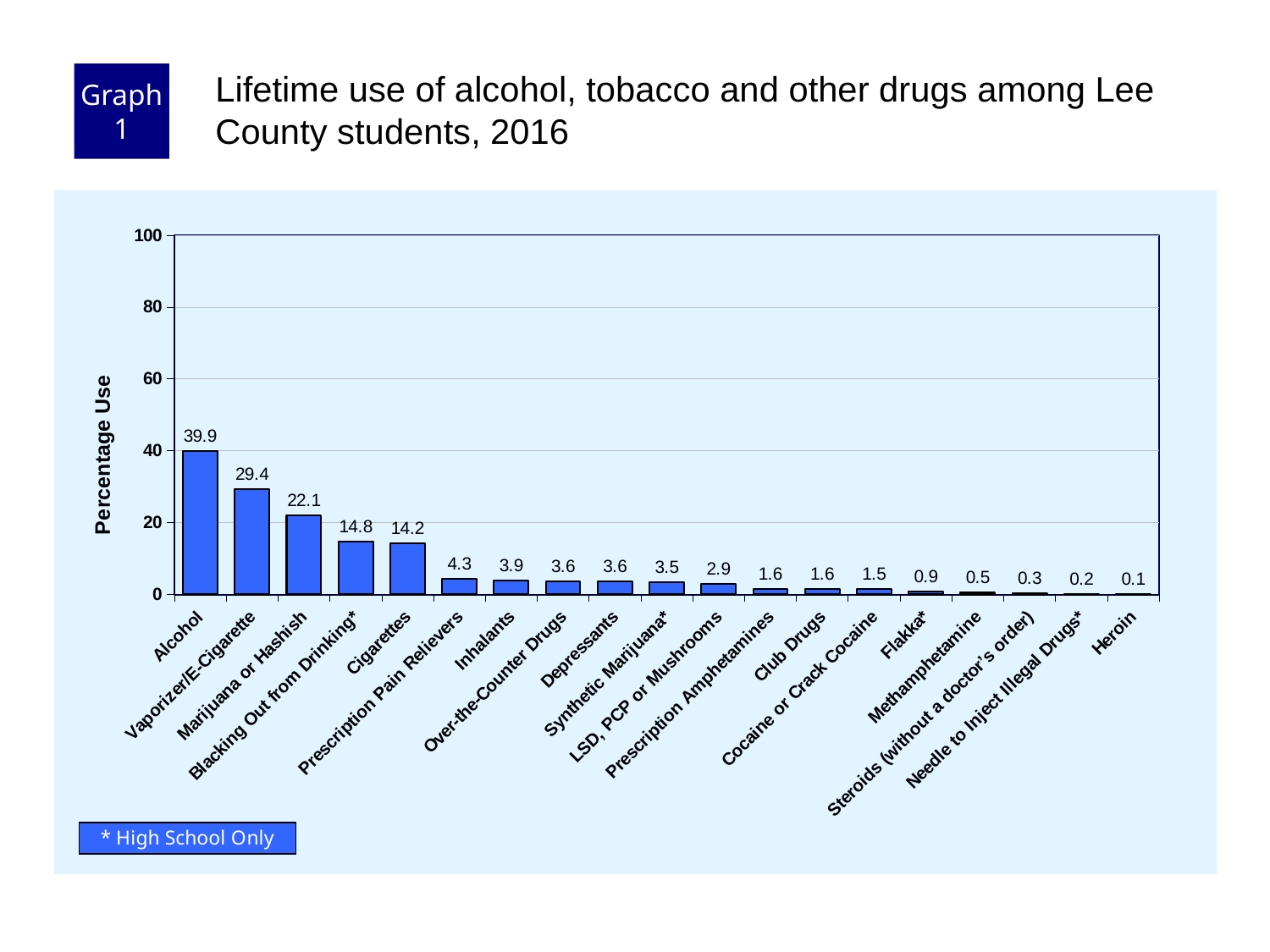
What is the percentage use for Cigarettes? 14.2 Is the value for Vaporizer/E-Cigarette greater or less than 20? greater How many categories are shown on the chart? 19 Which has a higher percentage use, Marijuana or Hashish or Cigarettes? Marijuana or Hashish Which category has the lowest percentage use? Heroin What is the percentage use for Alcohol? 39.9 Which category has the highest percentage use? Alcohol What is the difference in percentage use between Alcohol and Vaporizer/E-Cigarette? 10.5 What is the label of the y axis? Percentage Use What kind of chart is shown on the slide? Bar chart What is the percentage use for Inhalants? 3.9 What is the percentage use for Methamphetamine? 0.5